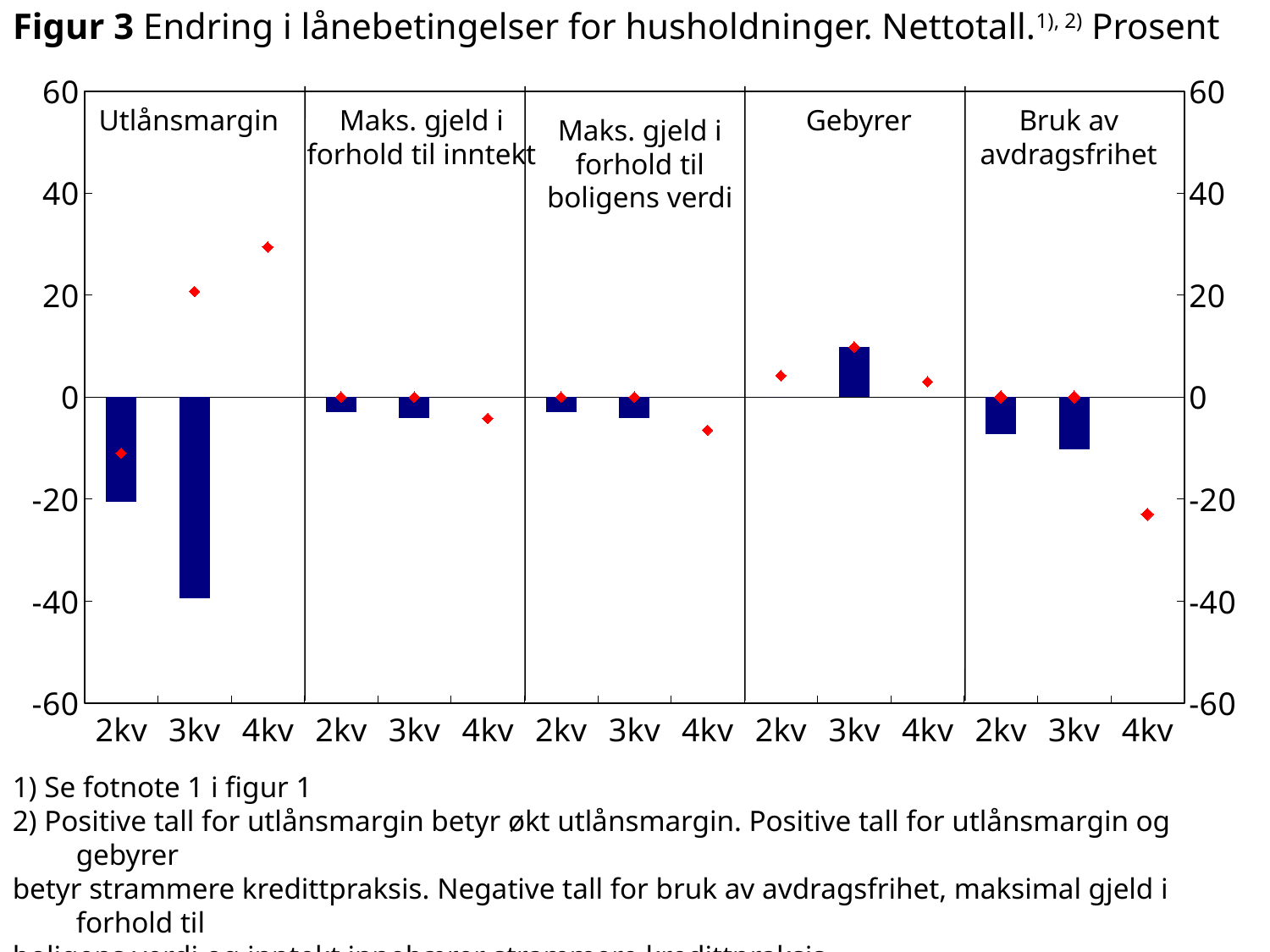
What is the title of the chart? Figur 3 Endring i lånebetingelser for husholdninger. Nettotall. Prosent What kind of chart is shown on the slide? bar chart Is the red marker value for 4kv in the Utlånsmargin panel greater or less than 20? greater Is the bar value for 3kv in the Utlånsmargin panel greater or less than -20? less How many quarters are plotted within each panel of the chart? 3 In the Utlånsmargin panel, which quarter has the lower bar, 2kv or 3kv? 3kv Is the bar value for 3kv in the Gebyrer panel greater or less than 20? less What are the minimum and maximum values shown on the vertical axis? -60 and 60 Which panel and quarter has the highest bar in the whole chart? Gebyrer, 3kv Which panel and quarter has the lowest bar in the whole chart? Utlånsmargin, 3kv How many lending-condition panels (categories) does the chart show? 5